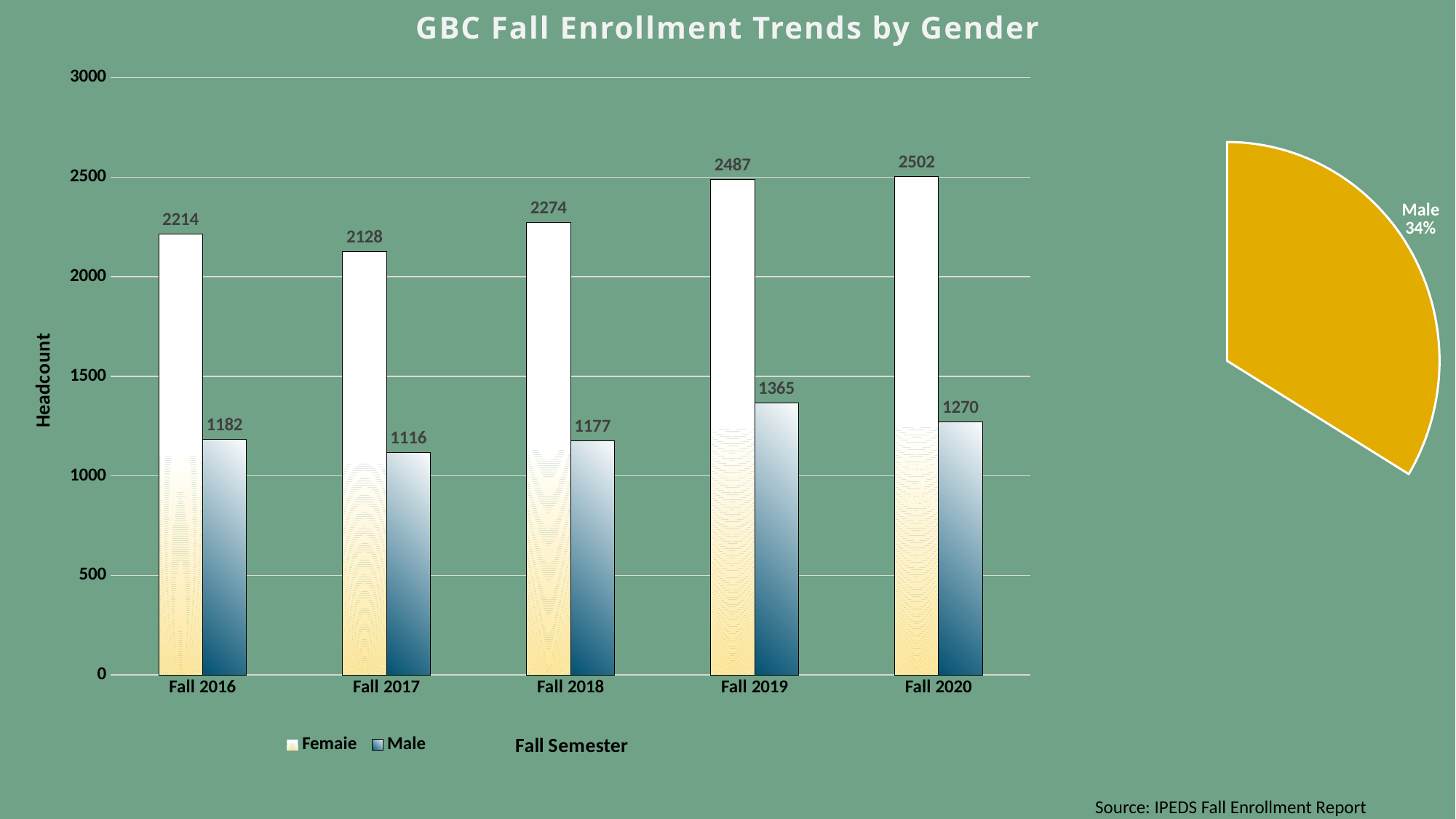
In the bar chart, what is the Male headcount for Fall 2017? 1116 In the bar chart, what is the Female headcount for Fall 2020? 2502 In the bar chart, is the Male headcount higher in Fall 2019 or Fall 2020? Fall 2019 In the bar chart, is the Female headcount for Fall 2017 greater or less than 2000? greater In the pie chart on the right of the slide, what share is labelled for Male? 34% How many series does the legend of the bar chart list? 2 How many fall semesters are shown on the x axis of the bar chart? 5 In the bar chart, what is the difference between the Female and Male headcounts in Fall 2018? 1097 What type of chart is the chart titled 'GBC Fall Enrollment Trends by Gender'? bar chart In the bar chart, which fall semester has the lowest Male headcount? Fall 2017 In the bar chart, which fall semester has the highest Female headcount? Fall 2020 In the bar chart, what is the Male headcount for Fall 2019? 1365